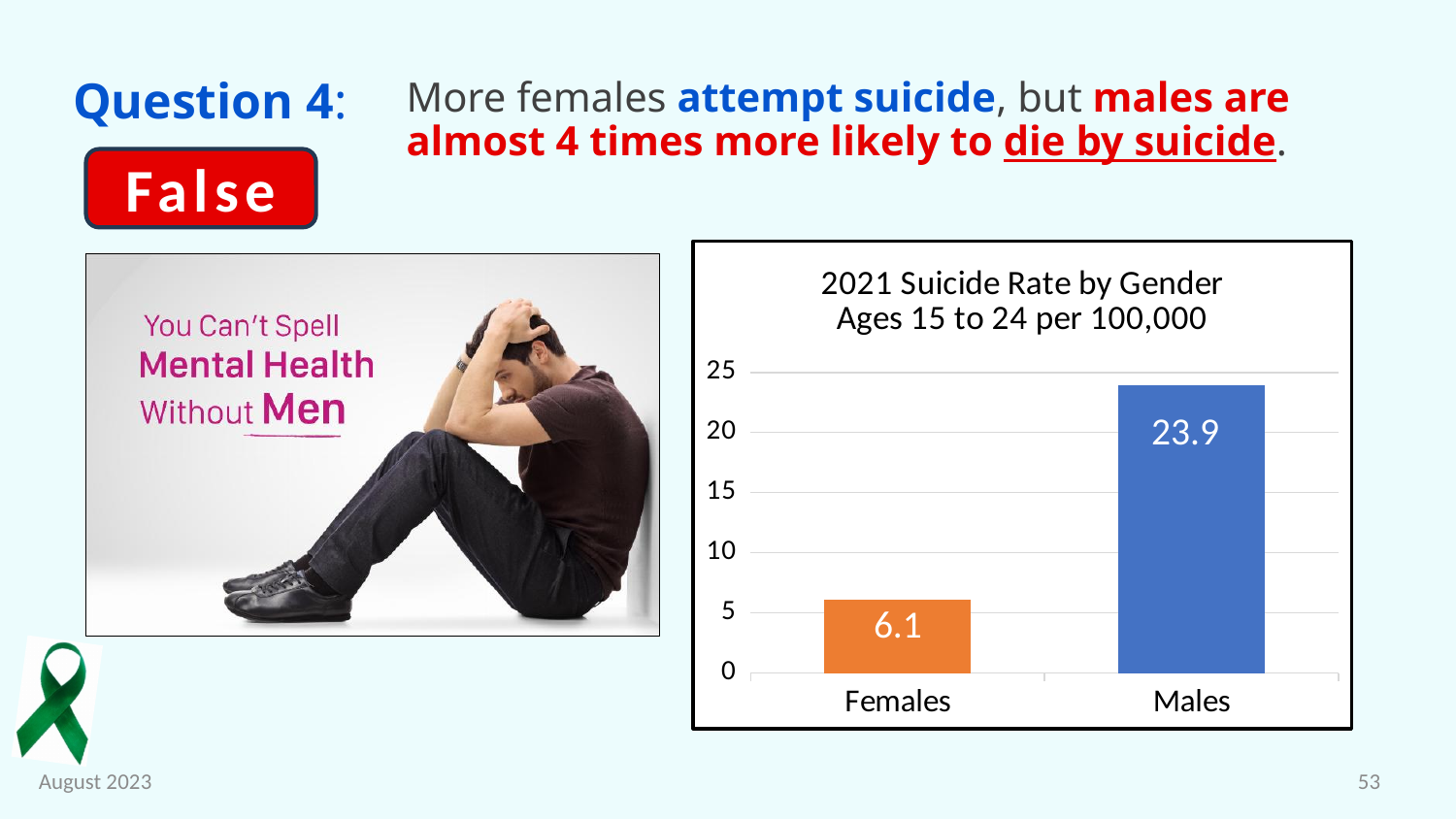
What is the suicide rate for Females in the chart? 6.1 How many categories are shown on the x axis of the chart? 2 Which gender has the higher suicide rate in the chart? Males What is the highest value shown on the chart's vertical axis? 25 What is the title of the chart? 2021 Suicide Rate by Gender Ages 15 to 24 per 100,000 What kind of chart is shown on the slide? Bar chart Is the value for Females greater or less than 10? less Is the value for Males greater or less than 20? greater Which gender has the lower suicide rate in the chart? Females What colour is the bar for Males in the chart? Blue What is the suicide rate for Males in the chart? 23.9 What is the difference between the Males and Females suicide rates shown in the chart? 17.8